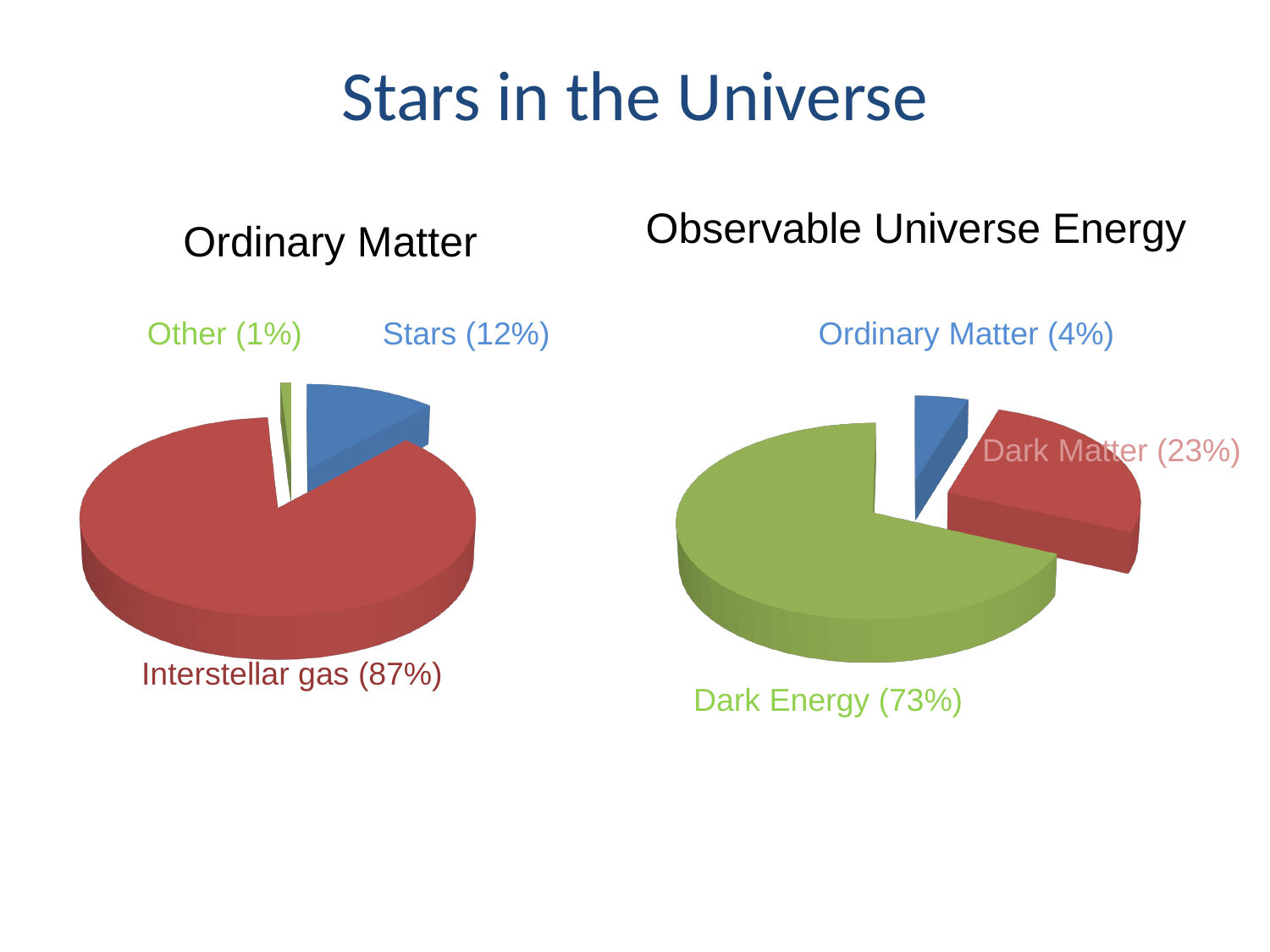
In the Observable Universe Energy chart, which is larger, Dark Matter or Ordinary Matter? Dark Matter In the Observable Universe Energy chart, what is the difference between the Dark Energy and Dark Matter shares? 50% How many slices does the Observable Universe Energy chart have? 3 In the Ordinary Matter chart, what share does Interstellar gas have? 87% In the Observable Universe Energy chart, which category has the smallest slice? Ordinary Matter In the Ordinary Matter chart, which category has the largest slice? Interstellar gas In the Observable Universe Energy chart, what share does Dark Energy have? 73% In the Ordinary Matter chart, what share do Stars have? 12% In the Observable Universe Energy chart, what share does Dark Matter have? 23% In the Ordinary Matter chart, which category has the smallest slice? Other What kind of chart is the Ordinary Matter chart? Pie chart In the Ordinary Matter chart, what is the difference between the Stars and Other shares? 11%